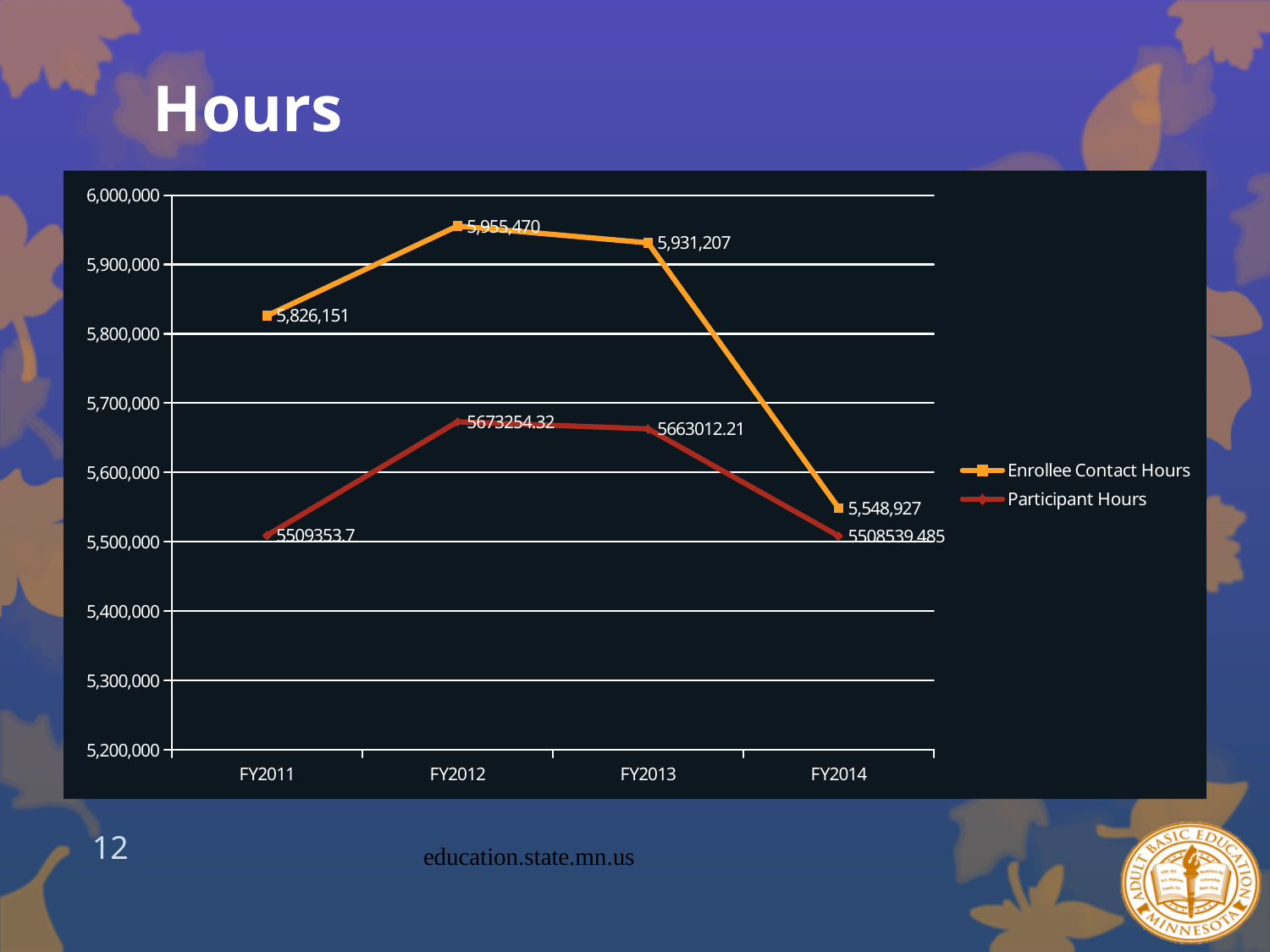
Which is larger in FY2013: Enrollee Contact Hours or Participant Hours? Enrollee Contact Hours How many series does the legend list? 2 What is the value of Enrollee Contact Hours for FY2012? 5,955,470 Is the value of Participant Hours for FY2011 greater or less than 5,600,000? less What is the value of Participant Hours for FY2013? 5663012.21 How many fiscal years are plotted on the x axis? 4 What kind of chart is shown on the slide? line chart In which fiscal year are Enrollee Contact Hours lowest? FY2014 What is the difference in Enrollee Contact Hours between FY2012 and FY2013? 24,263 What is the value of Enrollee Contact Hours for FY2014? 5,548,927 In which fiscal year are Enrollee Contact Hours highest? FY2012 What is the value of Participant Hours for FY2011? 5509353.7